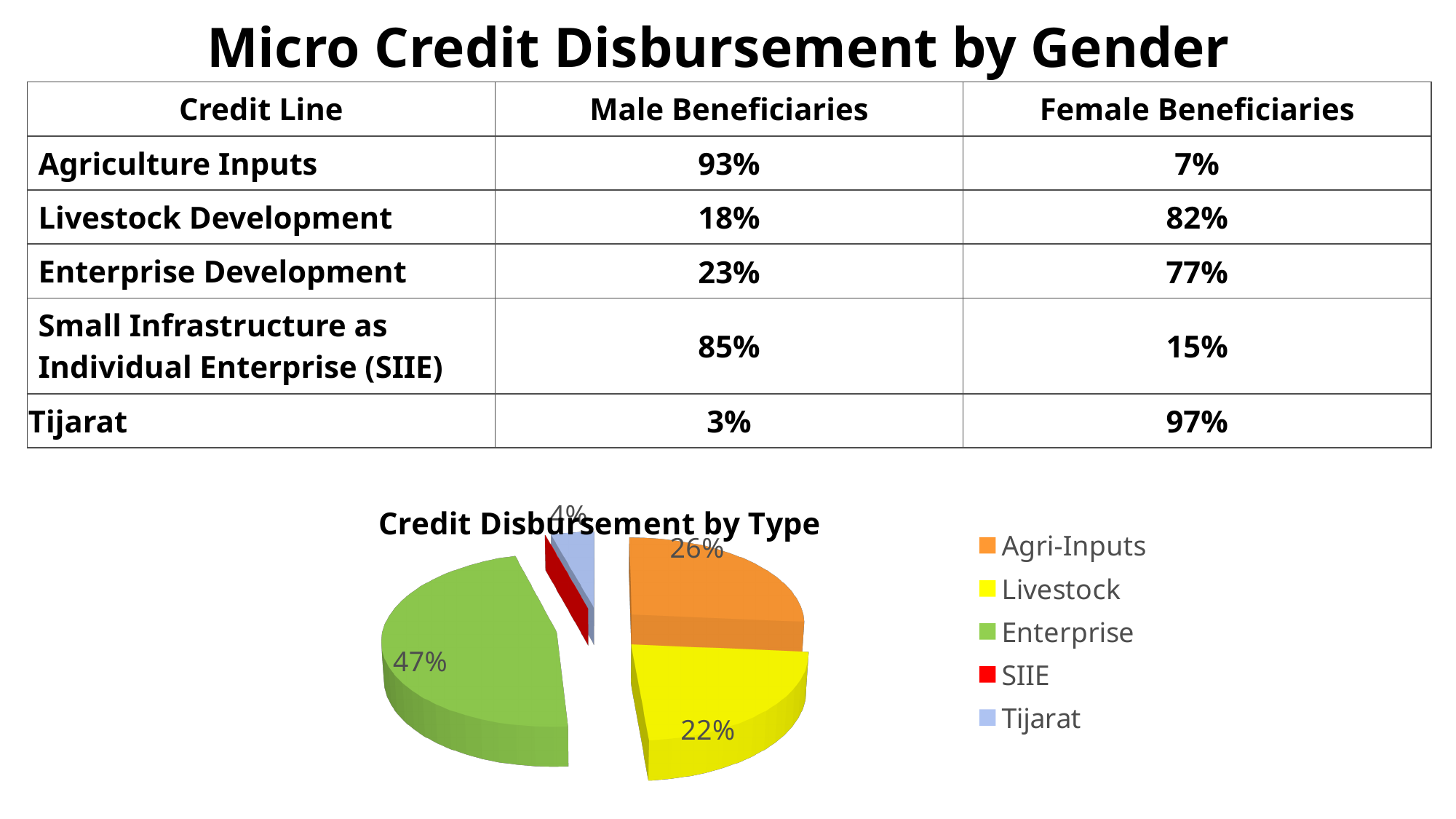
In the "Credit Disbursement by Type" pie chart, what share does Enterprise have? 47% How many entries does the legend of the "Credit Disbursement by Type" pie chart list? 5 In the "Credit Disbursement by Type" pie chart, which is larger, Agri-Inputs or Livestock? Agri-Inputs In the "Credit Disbursement by Type" pie chart, what share does Agri-Inputs have? 26% In the "Credit Disbursement by Type" pie chart, how many percentage points larger is Agri-Inputs than Livestock? 4 In the "Credit Disbursement by Type" pie chart, what colour is the Enterprise slice? green In the "Credit Disbursement by Type" pie chart, what share does Tijarat have? 4% In the "Credit Disbursement by Type" pie chart, which is larger, Enterprise or Tijarat? Enterprise In the "Credit Disbursement by Type" pie chart, which type has the largest share? Enterprise In the "Credit Disbursement by Type" pie chart, how many percentage points larger is Enterprise than Agri-Inputs? 21 What kind of chart is the "Credit Disbursement by Type" chart? pie chart